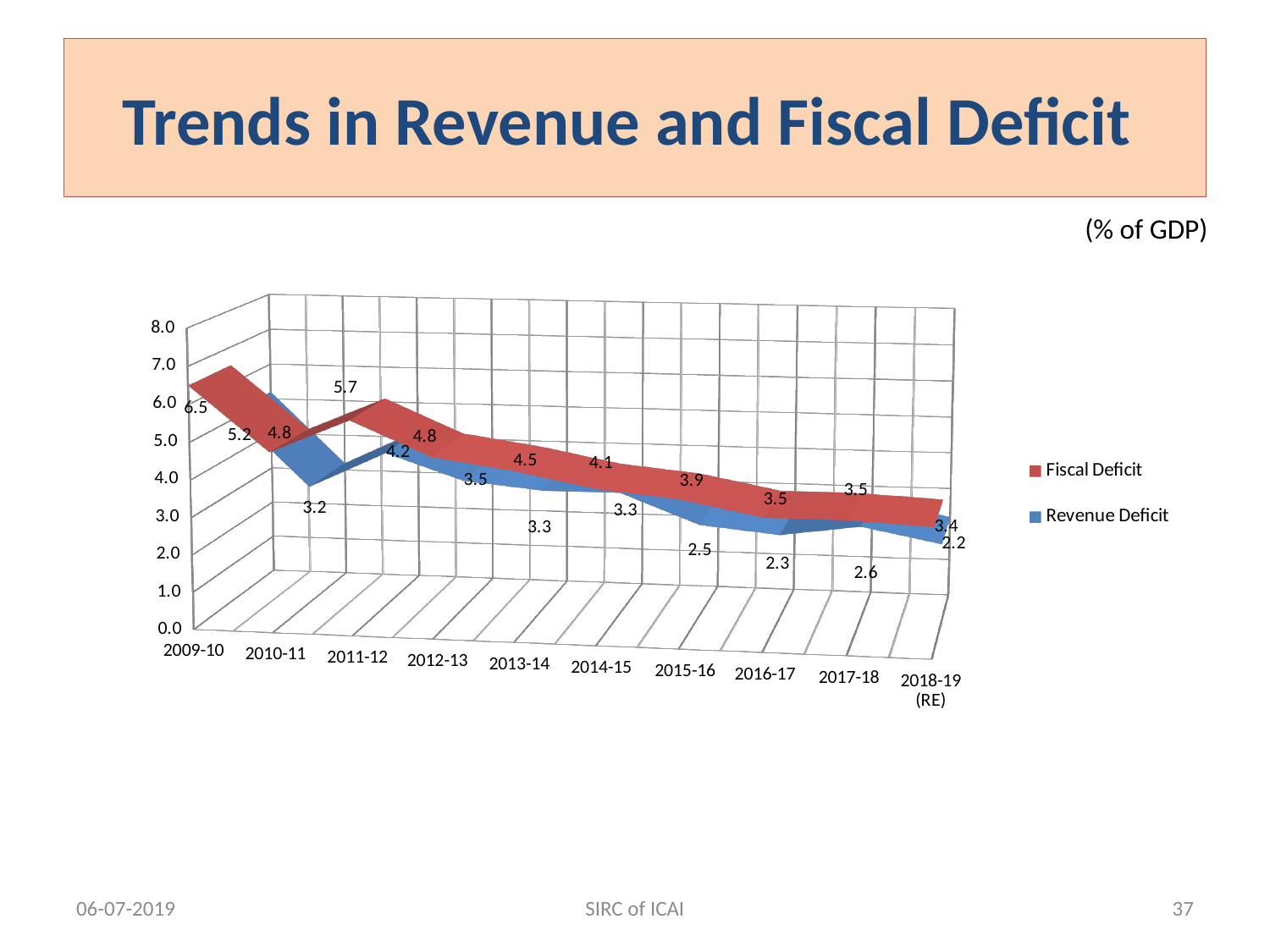
What is the Fiscal Deficit value for 2009-10? 6.5 In which year is the Fiscal Deficit highest? 2009-10 What is the Fiscal Deficit value for 2011-12? 5.7 Which is larger in 2016-17, the Fiscal Deficit or the Revenue Deficit? Fiscal Deficit How many series does the legend list? 2 What is the difference between the Fiscal Deficit and the Revenue Deficit in 2009-10? 1.3 What kind of chart is shown on the slide? Line chart How many years are shown on the x axis of the chart? 10 What is the Revenue Deficit value for 2015-16? 2.5 In which year is the Revenue Deficit lowest? 2018-19 (RE) What is the Revenue Deficit value for 2018-19 (RE)? 2.2 Overall, does the Fiscal Deficit rise or fall from 2009-10 to 2018-19 (RE)? Fall